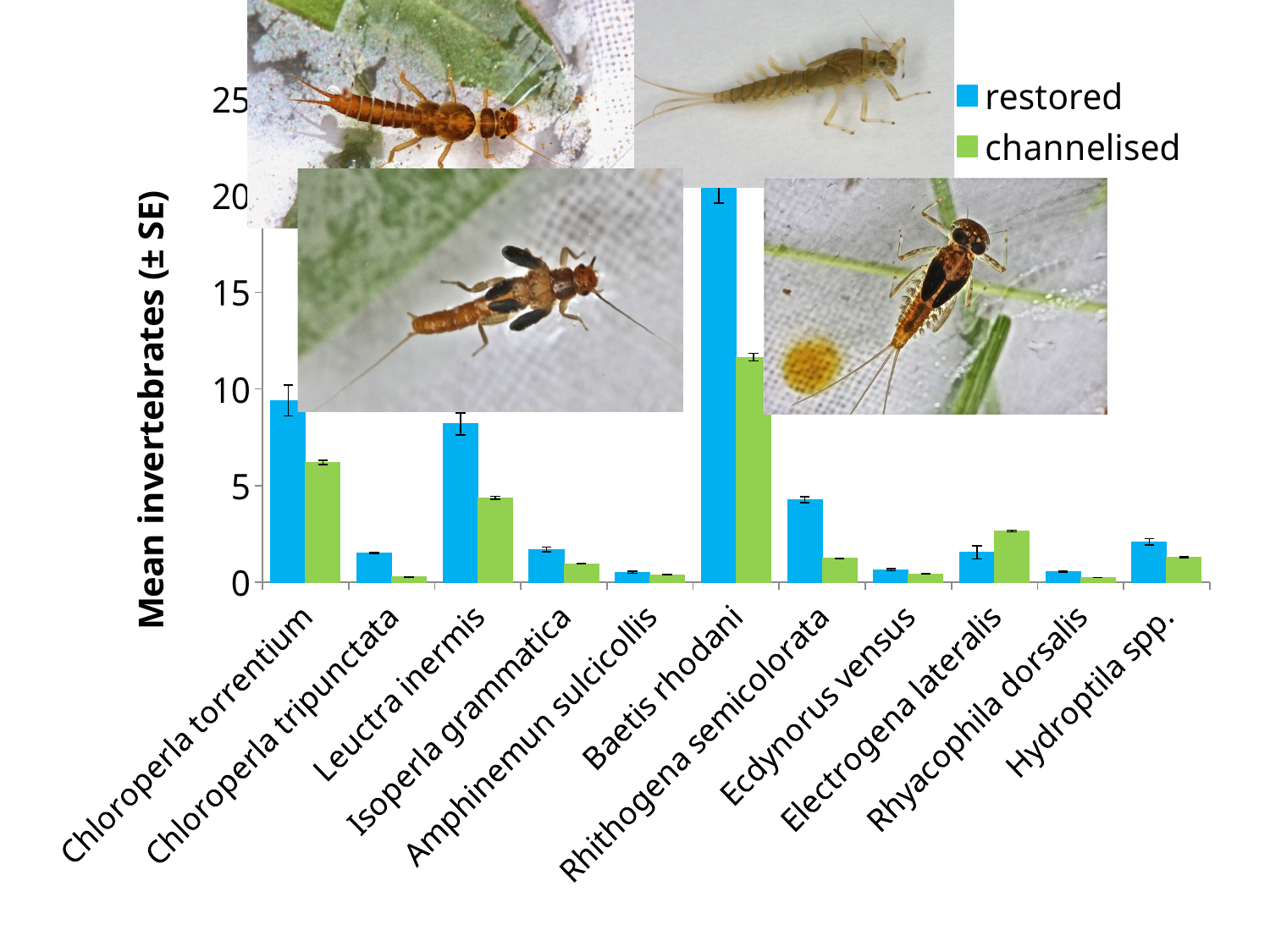
For Electrogena lateralis, which is larger: the restored value or the channelised value? channelised For Chloroperla torrentium, which is larger: the restored value or the channelised value? restored Is the restored value for Baetis rhodani greater or less than 15? greater Is the restored value for Leuctra inermis greater or less than 5? greater What is the label on the y axis? Mean invertebrates (± SE) Which species has the highest channelised value? Baetis rhodani What kind of chart is shown on the slide? bar chart Is the restored value for Chloroperla torrentium greater or less than 10? less How many species categories are shown along the x axis? 11 How many series does the legend list? 2 Which species has the highest restored value? Baetis rhodani